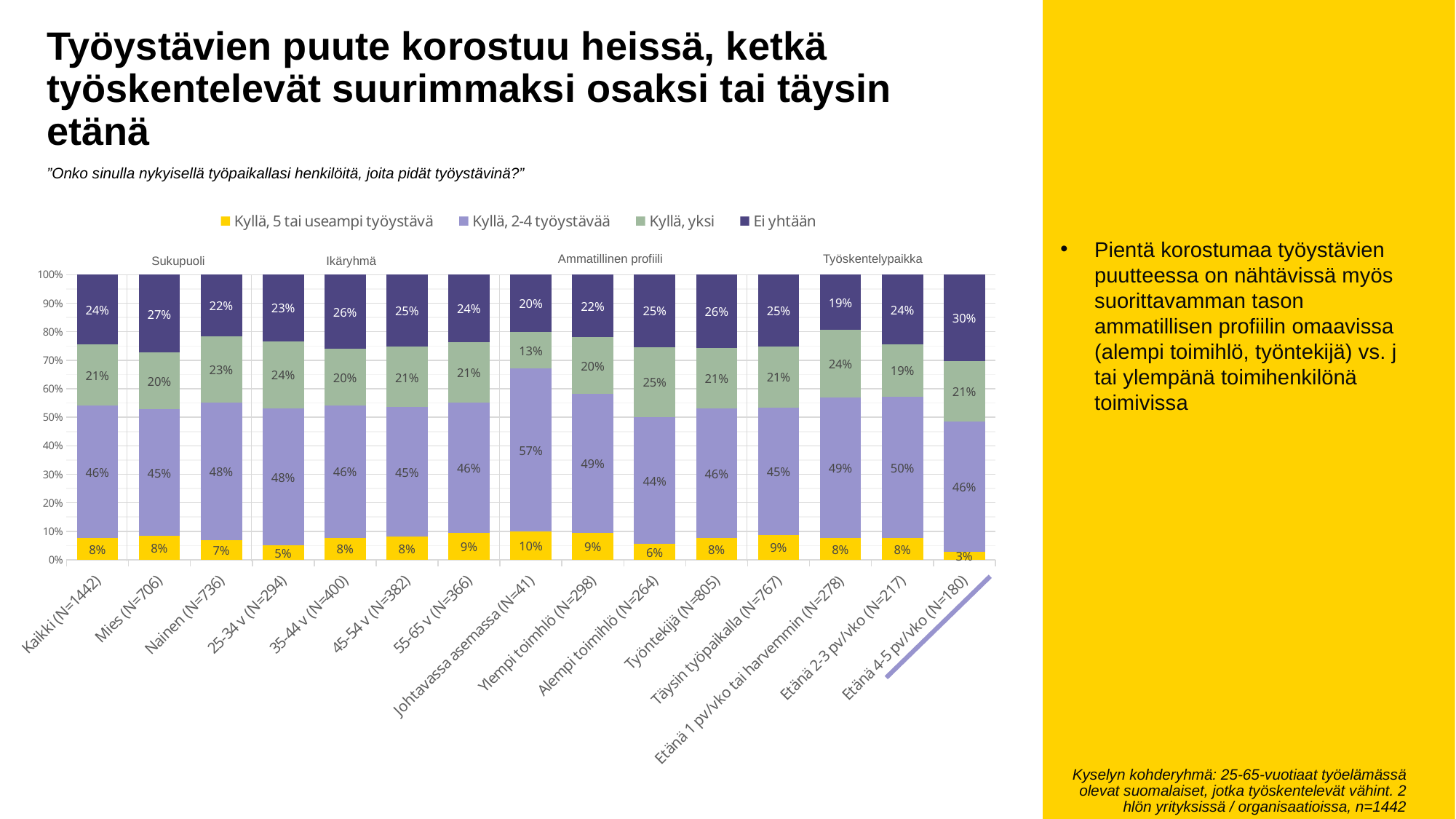
What is the value of "Kyllä, 2-4 työystävää" for Johtavassa asemassa (N=41)? 57% Which series is shown in yellow in the legend? Kyllä, 5 tai useampi työystävä How many categories (bars) are plotted along the x axis? 15 What is the difference between the "Ei yhtään" values for Etänä 4-5 pv/vko (N=180) and Etänä 1 pv/vko tai harvemmin (N=278)? 11 percentage points What is the total of the stacked bar for Mies (N=706)? 100% Which category has the lowest value for "Kyllä, 5 tai useampi työystävä"? Etänä 4-5 pv/vko (N=180) Which is larger: the "Kyllä, yksi" value for Alempi toimihlö (N=264) or for Johtavassa asemassa (N=41)? Alempi toimihlö (N=264) What kind of chart is shown on the slide? Stacked bar chart What is the value of "Kyllä, 5 tai useampi työystävä" for Kaikki (N=1442)? 8% What is the value of "Ei yhtään" for Etänä 4-5 pv/vko (N=180)? 30% Which category has the highest value for "Ei yhtään"? Etänä 4-5 pv/vko (N=180) How many series does the legend list? 4